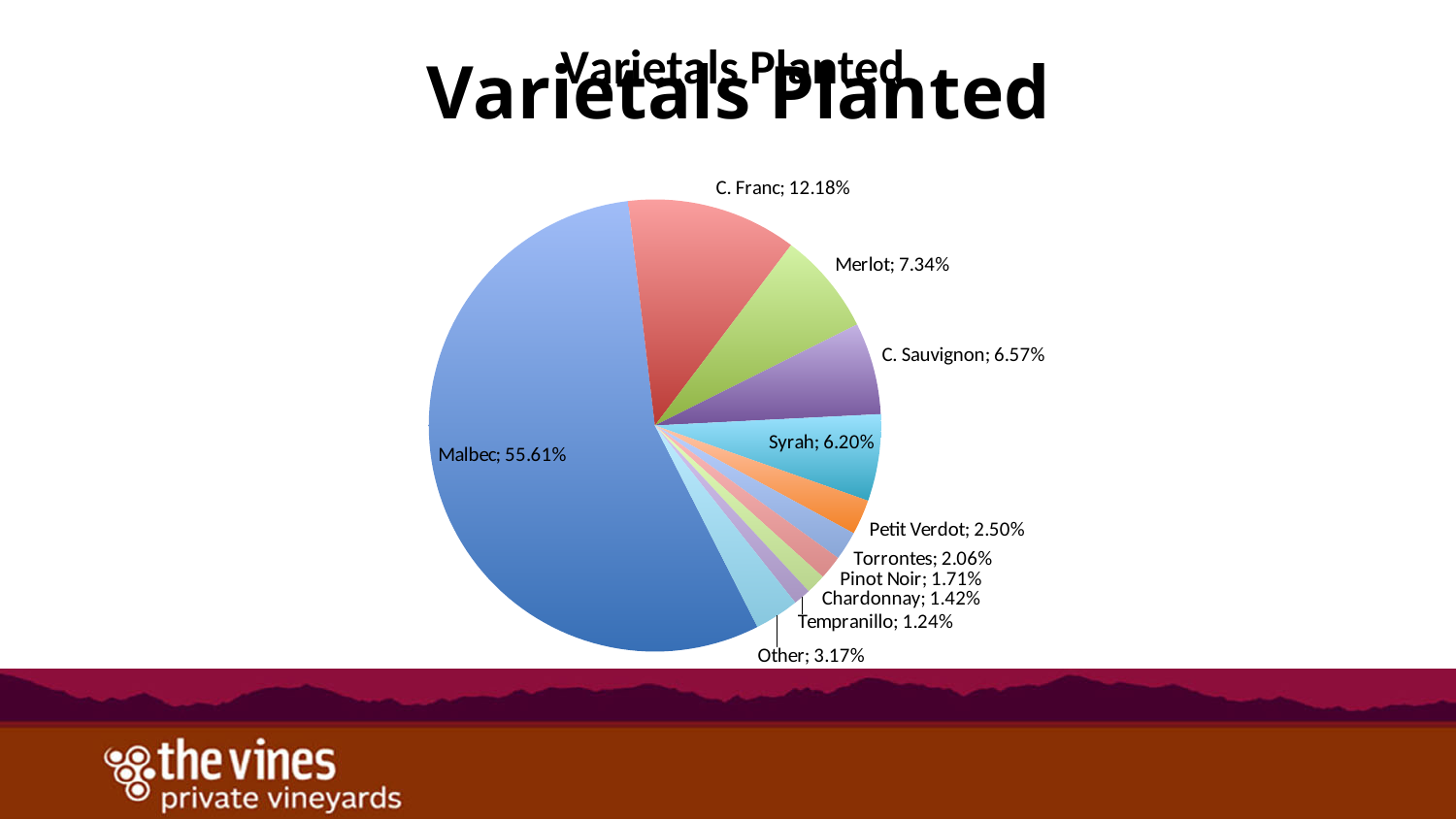
Which varietal has the largest slice of the pie? Malbec What is the title of the chart? Varietals Planted Which is larger, the share for Petit Verdot or the share for Torrontes? Petit Verdot Which varietal has the smallest slice of the pie? Tempranillo What is the combined share of Pinot Noir and Chardonnay? 3.13% How many slices does the pie chart have? 11 What is the difference in percentage points between Merlot and C. Sauvignon? 0.77 What percentage is shown for Tempranillo? 1.24% What percentage is shown for Syrah? 6.20% What percentage is shown for C. Franc? 12.18% What type of chart is shown on the slide? Pie chart What share of varietals planted is Malbec? 55.61%